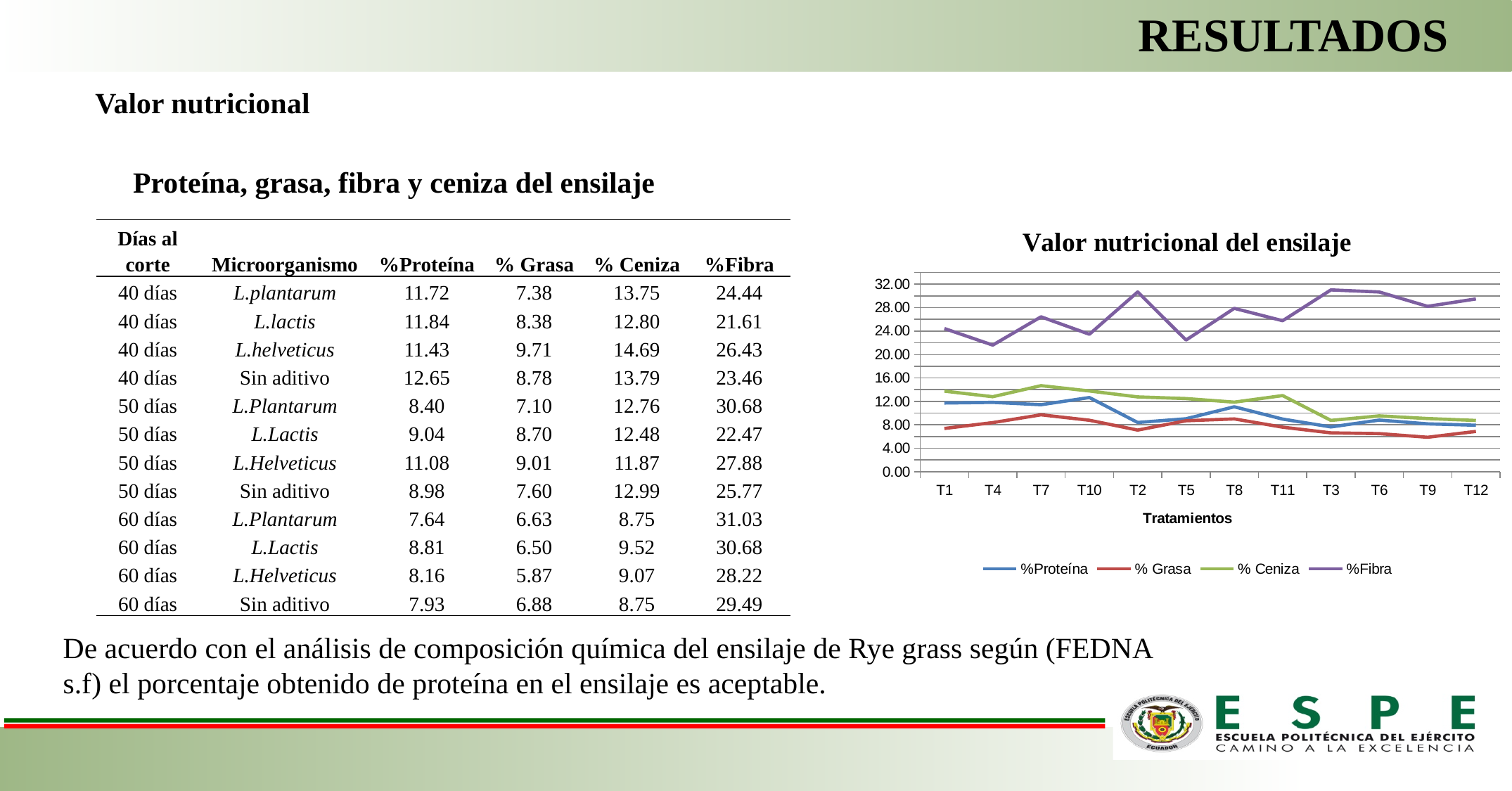
In the 'Valor nutricional del ensilaje' chart, which series has the lowest values across all treatments? % Grasa In the 'Valor nutricional del ensilaje' chart, is the %Fibra value for T3 greater or less than 28.00? greater How many series does the legend of the 'Valor nutricional del ensilaje' chart list? 4 What kind of chart is 'Valor nutricional del ensilaje'? line chart In the 'Valor nutricional del ensilaje' chart, is the % Grasa value for T9 greater or less than 8.00? less What is the x-axis title of the 'Valor nutricional del ensilaje' chart? Tratamientos In the 'Valor nutricional del ensilaje' chart, which is larger: the %Proteína value for T10 or for T2? T10 In the 'Valor nutricional del ensilaje' chart, is the % Ceniza value for T7 greater or less than 12.00? greater How many treatments are shown on the x axis of the 'Valor nutricional del ensilaje' chart? 12 In the 'Valor nutricional del ensilaje' chart, does the % Ceniza series generally rise or fall from T1 to T12? fall In the 'Valor nutricional del ensilaje' chart, which series has the highest values across all treatments? %Fibra